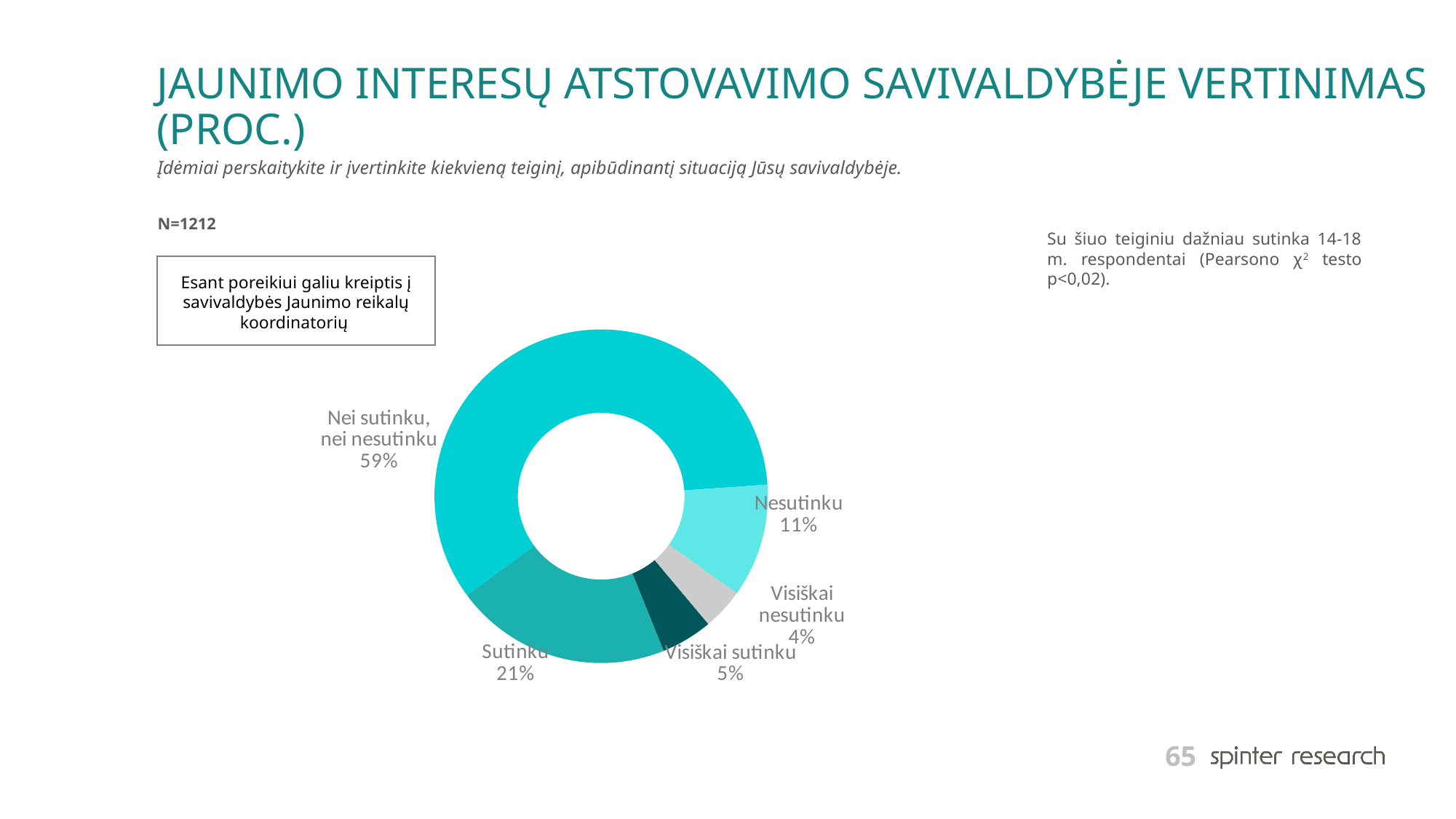
Which is larger, the share for "Sutinku" or the share for "Nesutinku"? Sutinku What is the difference in percentage points between "Sutinku" and "Nesutinku"? 10 What percentage of respondents answered "Sutinku"? 21% What percentage of respondents answered "Nesutinku"? 11% How many response categories are shown in the chart? 5 Which response category has the smallest share of the pie? Visiškai nesutinku What kind of chart is shown on the slide? Pie chart (doughnut) What percentage of respondents answered "Nei sutinku, nei nesutinku"? 59% What percentage of respondents answered "Visiškai sutinku"? 5% What is the sample size (N) stated on the slide? N=1212 Which response category has the largest share of the pie? Nei sutinku, nei nesutinku What percentage of respondents answered "Visiškai nesutinku"? 4%